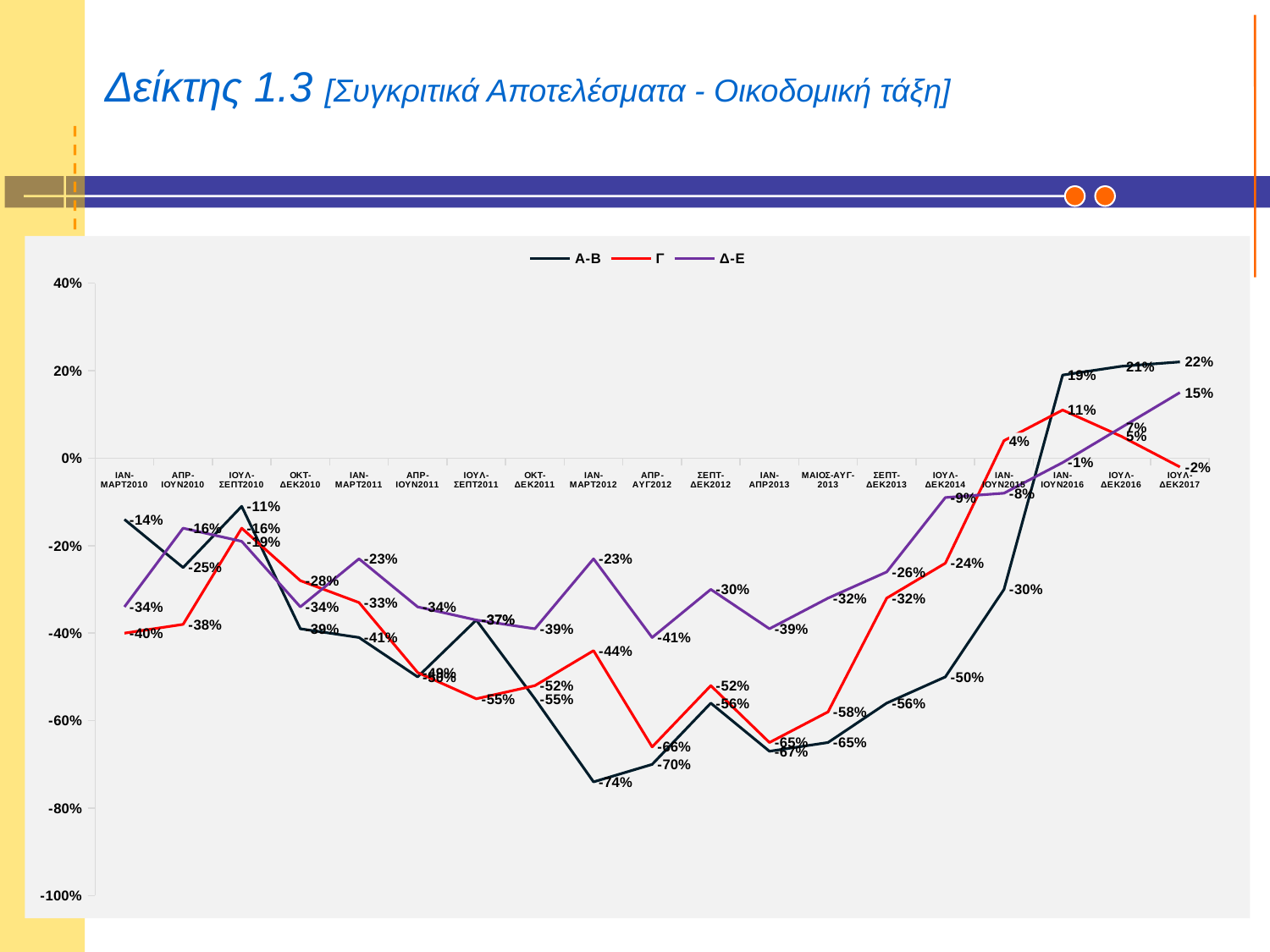
What is the value of the Γ series for ΙΑΝ-ΙΟΥΝ2016? 11% What is the value of the Δ-Ε series for ΙΟΥΛ-ΔΕΚ2017? 15% What is the value of the Γ series for ΙΑΝ-ΜΑΡΤ2010? -40% In which period does the Α-Β series reach its highest value? ΙΟΥΛ-ΔΕΚ2017 How many series does the legend list? 3 What is the value of the Α-Β series for ΙΑΝ-ΜΑΡΤ2012? -74% In which period does the Α-Β series reach its lowest value? ΙΑΝ-ΜΑΡΤ2012 For ΙΟΥΛ-ΔΕΚ2017, which series has the higher value, Α-Β or Γ? Α-Β Which series are listed in the legend? Α-Β, Γ, Δ-Ε How many time periods are shown on the x axis? 19 What is the difference between the Α-Β value and the Δ-Ε value for ΙΟΥΛ-ΔΕΚ2017? 7 percentage points What type of chart is shown on the slide? Line chart